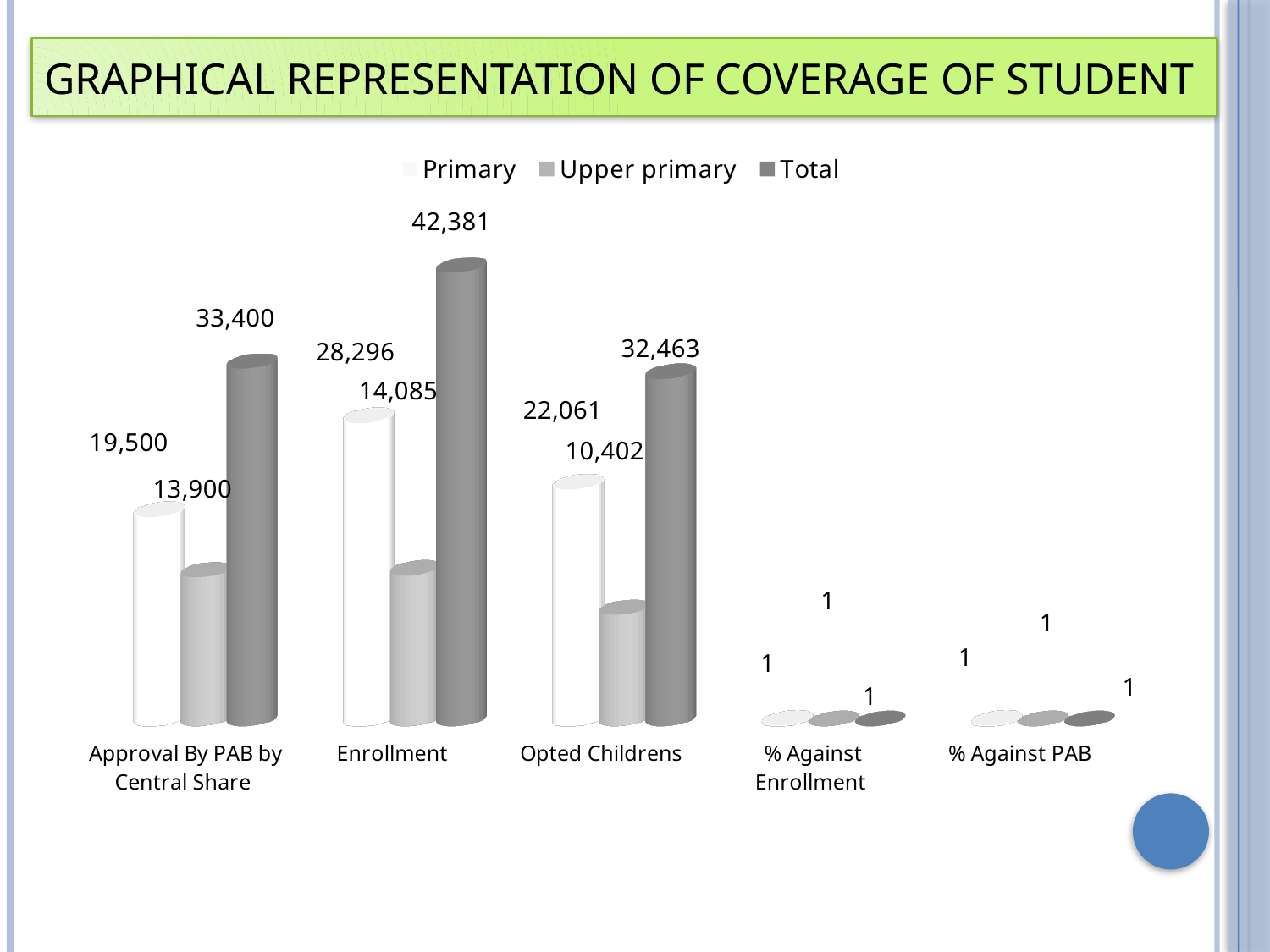
Which category has the highest Total value? Enrollment Which is larger: the Primary value for Opted Childrens or the Primary value for Approval By PAB by Central Share? Opted Childrens What is the difference between the Primary and Upper primary values for Enrollment? 14,211 What is the Upper primary value for Enrollment? 14,085 How many categories are shown on the x axis? 5 What is the Total value for Enrollment? 42,381 What is the Upper primary value for Opted Childrens? 10,402 What kind of chart is shown on the slide? Bar chart What is the Primary value for Approval By PAB by Central Share? 19,500 What is the difference between the Total values for Approval By PAB by Central Share and Opted Childrens? 937 Among Approval By PAB by Central Share, Enrollment and Opted Childrens, which has the lowest Upper primary value? Opted Childrens How many series does the legend list? 3